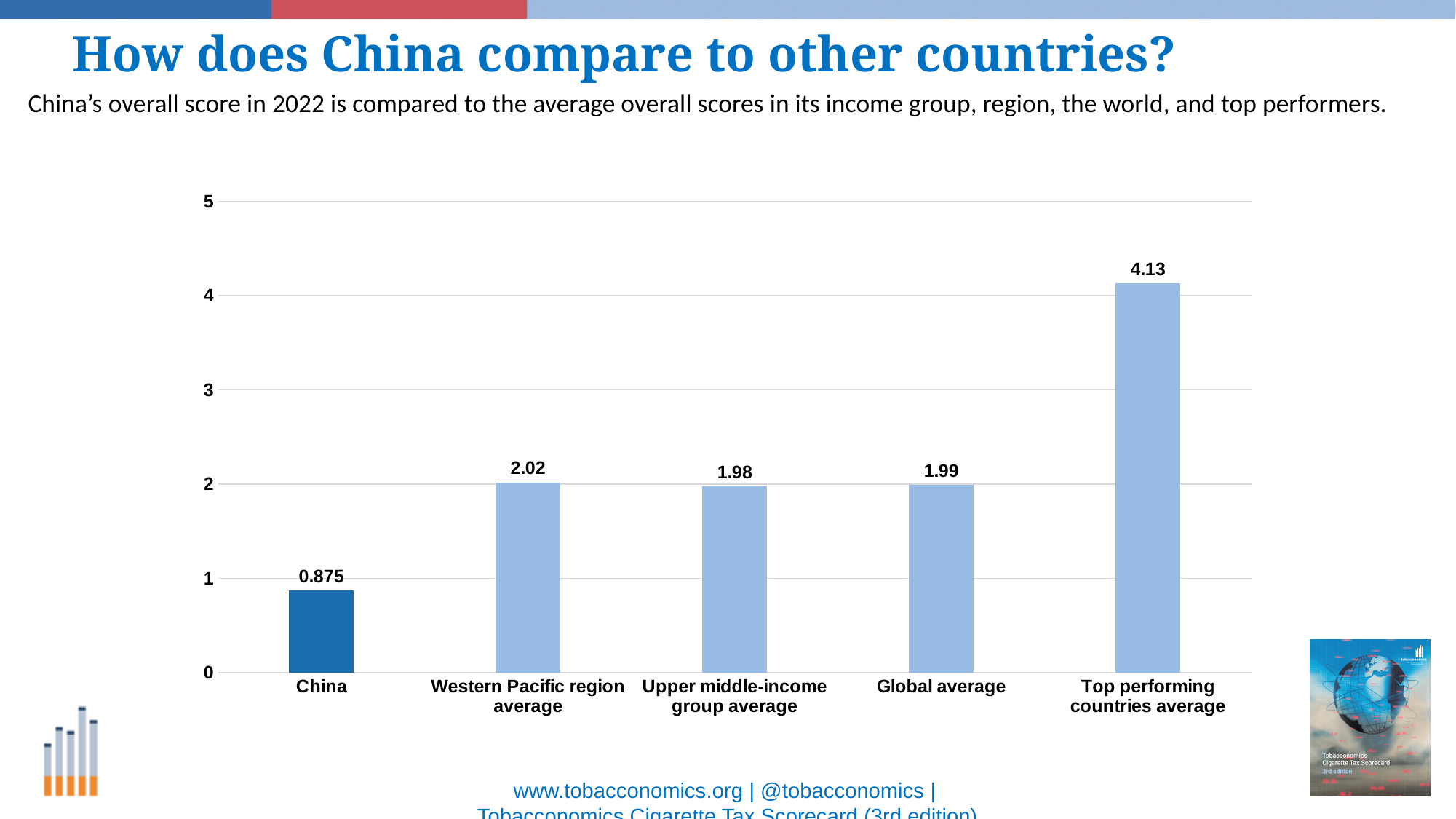
What kind of chart is shown on the slide? Bar chart What is the value for Top performing countries average? 4.13 What is the value for China? 0.875 What is the value for Global average? 1.99 What is the difference between the Top performing countries average and China? 3.255 Which category has the highest value? Top performing countries average Which is larger, the value for China or the value for Global average? Global average What is the difference between the Western Pacific region average and the Upper middle-income group average? 0.04 What is the value for Western Pacific region average? 2.02 How many categories are shown on the chart? 5 Which category has the lowest value? China Is the value for Top performing countries average greater or less than 4? greater